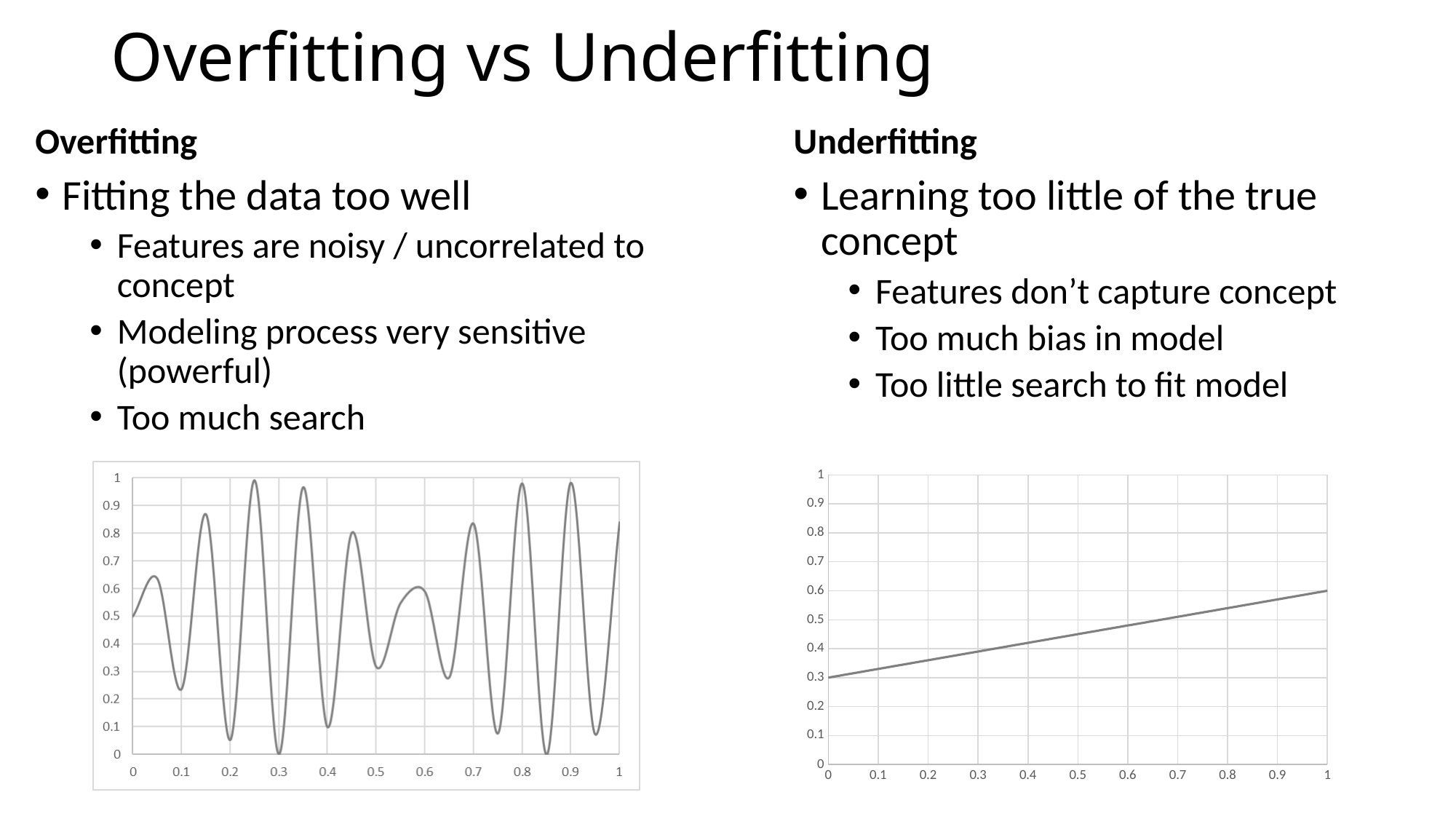
What kind of chart is shown under the Overfitting heading on the left? line chart In the Overfitting chart on the left, is the value at x = 0.25 greater or less than 0.9? greater What is the highest value shown on the y axis of the Underfitting chart on the right? 1 In the Overfitting chart on the left, what is the value of the line at x = 0? 0.5 In the Overfitting chart on the left, is the value at x = 0.2 greater or less than 0.1? less In the Underfitting chart on the right, what is the value of the line at x = 1? 0.6 In the Underfitting chart on the right, does the line rise or fall as x increases from 0 to 1? rises What kind of chart is shown under the Underfitting heading on the right? line chart In the Underfitting chart on the right, what is the difference between the line's value at x = 1 and at x = 0? 0.3 In the Underfitting chart on the right, what is the value of the line at x = 0? 0.3 In the Underfitting chart on the right, is the value at x = 0.9 greater or less than 0.5? greater In the Underfitting chart on the right, is the value at x = 0 or at x = 1 larger? x = 1